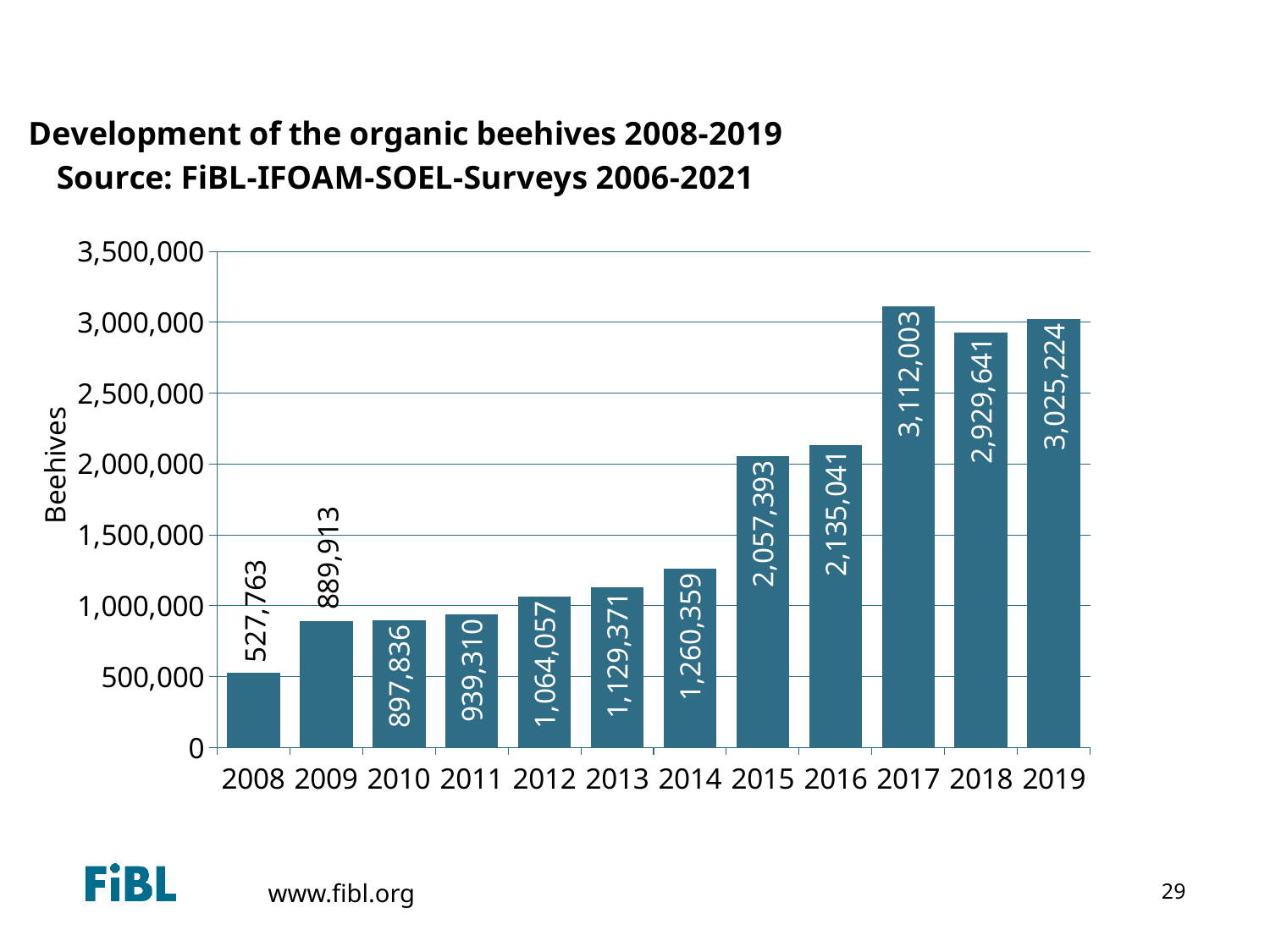
What is the number of organic beehives in 2015? 2,057,393 What is the difference in beehives between 2019 and 2018? 95,583 What is the number of organic beehives in 2019? 3,025,224 Which year has the highest number of organic beehives? 2017 What is the difference in beehives between 2017 and 2016? 976,962 Which year has the lowest number of organic beehives? 2008 Is the value for 2012 greater or less than 1,000,000? greater What kind of chart is shown on the slide? bar chart What is the number of organic beehives in 2008? 527,763 Which year has more organic beehives, 2014 or 2015? 2015 How many years are shown on the x axis? 12 What is the label of the y axis? Beehives